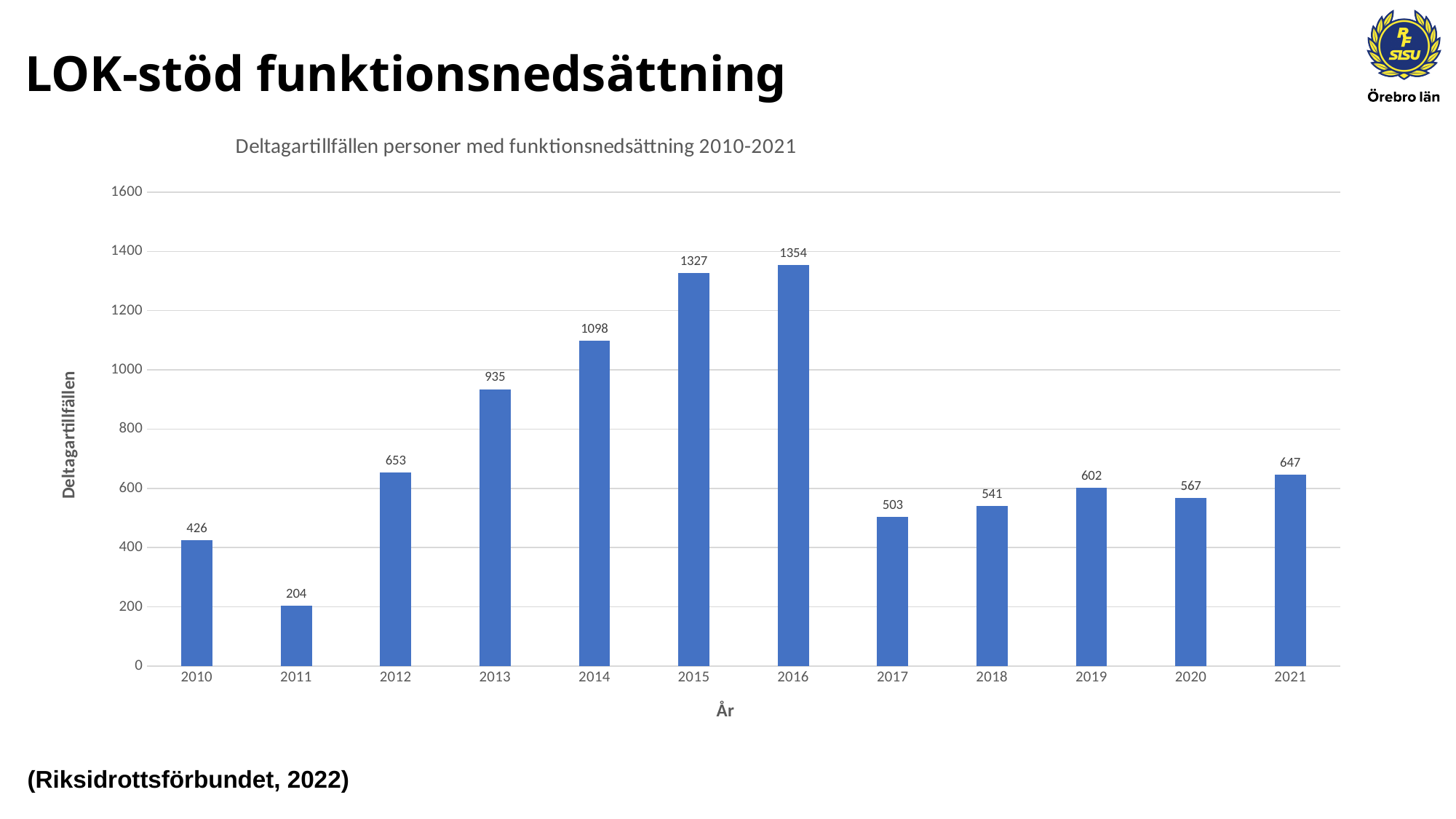
Which year has the lowest value? 2011 Is the value for 2017 greater or less than 600? less What kind of chart is shown on the slide? bar chart Which year has the highest value? 2016 What is the value for 2011? 204 What is the value for 2016? 1354 Which is larger, the value for 2012 or the value for 2021? 2012 What is the value for 2019? 602 How many years are shown on the x axis? 12 What is the difference between the values for 2016 and 2015? 27 What is the title of the chart? Deltagartillfällen personer med funktionsnedsättning 2010-2021 What is the difference between the values for 2014 and 2013? 163